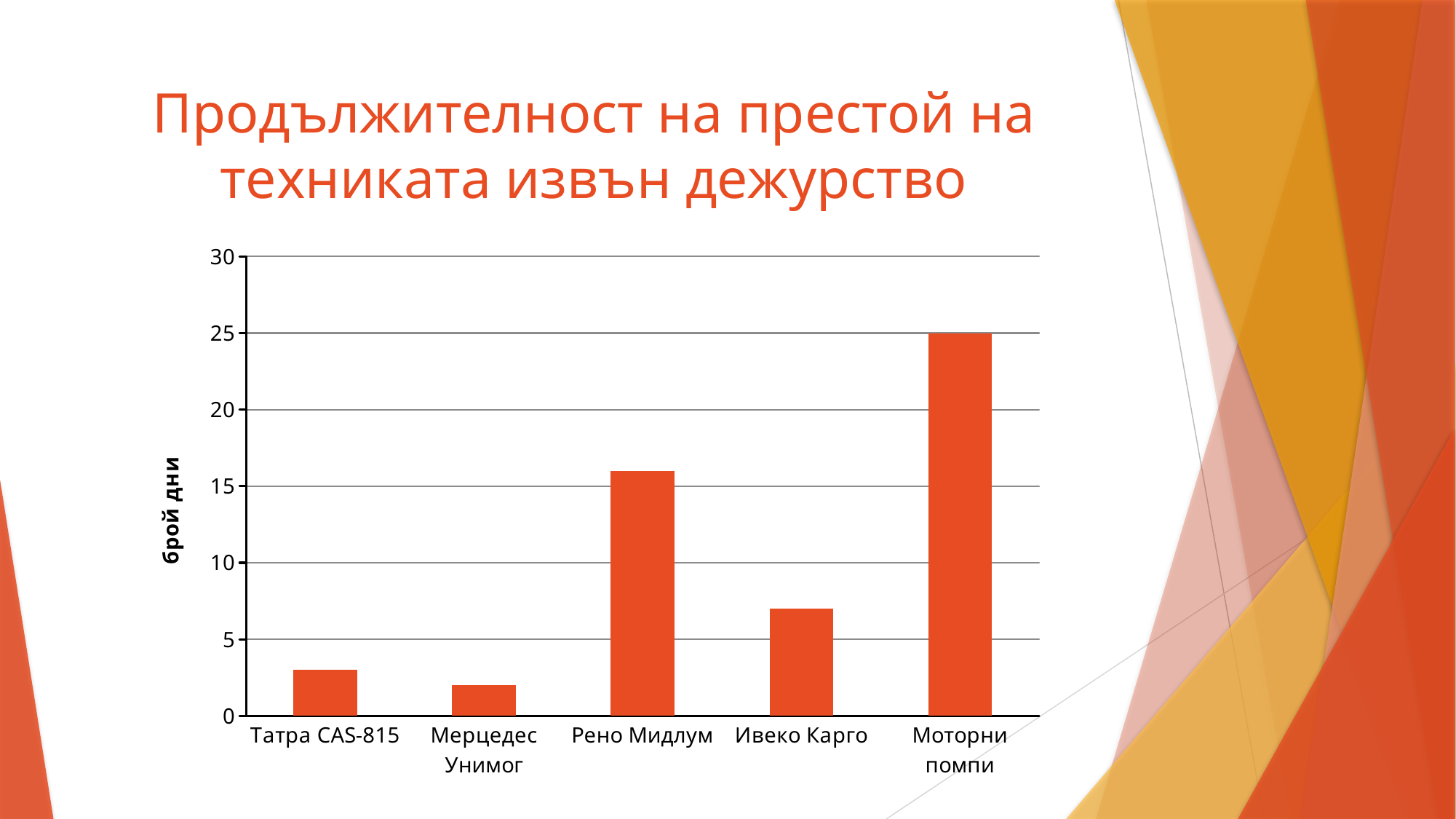
Is the value for Татра CAS-815 greater or less than 5? less Which category has the highest value in the chart? Моторни помпи What kind of chart is shown on the slide? bar chart What is the value for Моторни помпи? 25 What is the label of the vertical axis of the chart? брой дни How many categories are shown on the x axis of the chart? 5 What is the title of the slide containing the chart? Продължителност на престой на техниката извън дежурство Is the value for Мерцедес Унимог greater or less than 5? less Which category has the lowest value in the chart? Мерцедес Унимог Is the value for Ивеко Карго greater or less than 5? greater Which is larger, the value for Рено Мидлум or the value for Ивеко Карго? Рено Мидлум